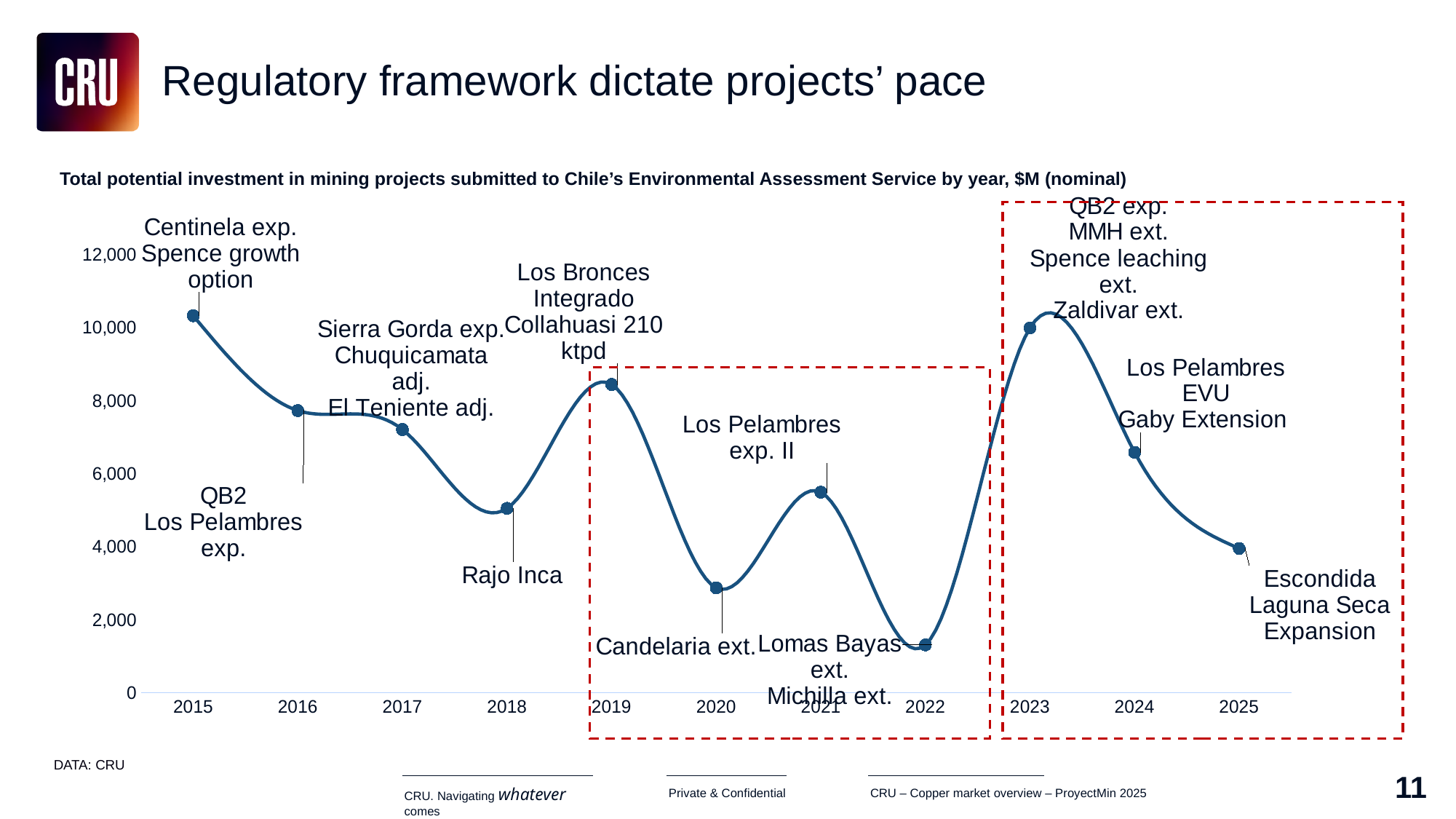
Is the value for 2022 greater or less than 2,000? less Is the value for 2018 greater or less than 6,000? less Which year has the lowest total potential investment? 2022 Which project is annotated at the 2018 data point? Rajo Inca How many years (data points) are plotted on the chart? 11 Is the value for 2023 greater or less than 8,000? greater Do the values rise or fall from 2023 to 2025? fall Which year has the larger value, 2020 or 2022? 2020 Which year has the larger value, 2019 or 2021? 2019 What kind of chart is shown on the slide? line chart